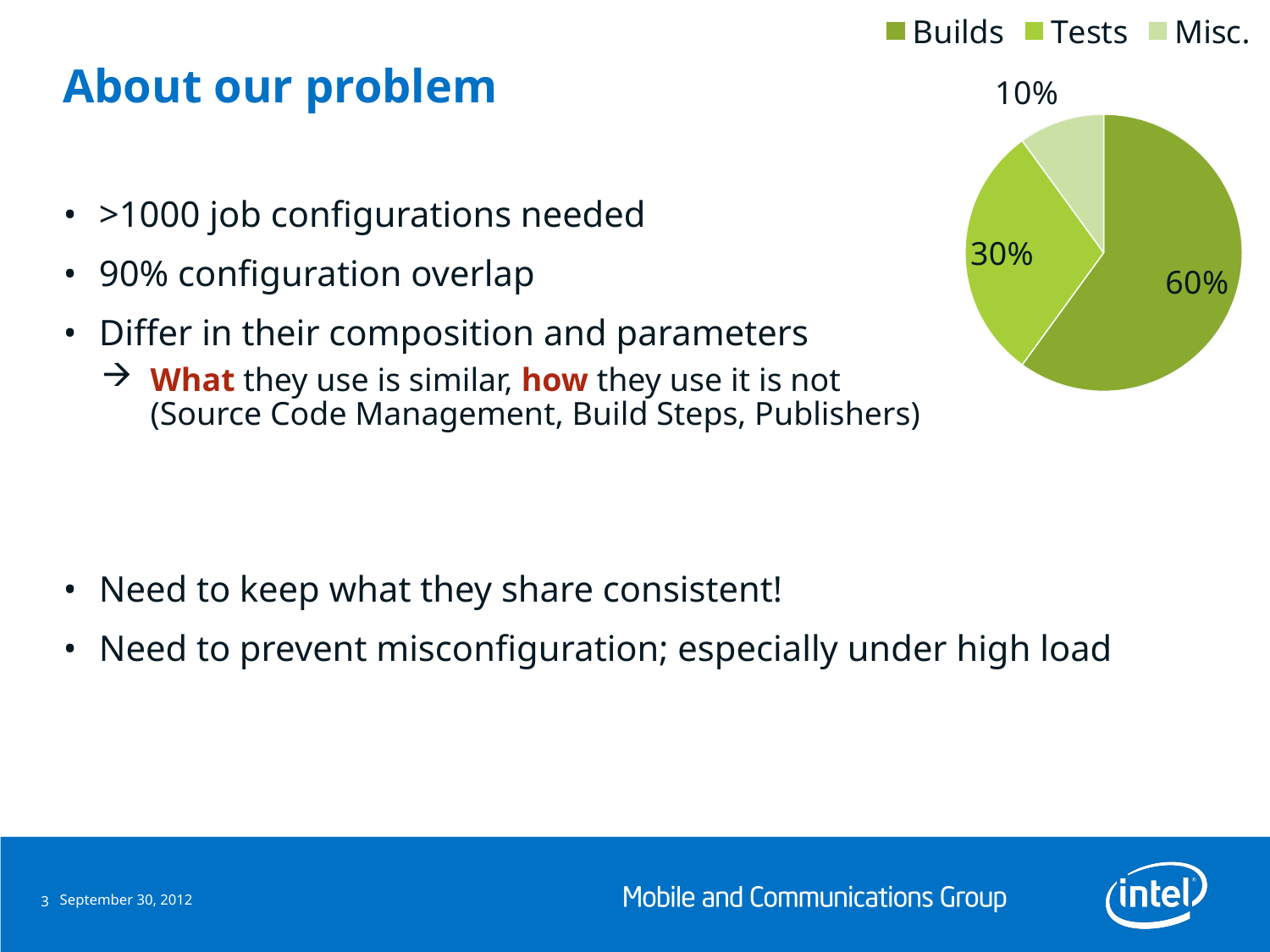
How many entries does the legend list? 3 What share of the pie does Tests take? 30% How many slices does the pie chart have? 3 What share of the pie does Misc. take? 10% What is the difference in percentage points between the Tests slice and the Misc. slice? 20% Which category has the largest slice of the pie? Builds What kind of chart is shown on the slide? pie chart What is the difference in percentage points between the Builds slice and the Tests slice? 30% Which legend entry is shown in the lightest green colour? Misc. What share of the pie does Builds take? 60% Which slice is larger, Tests or Misc.? Tests Which category has the smallest slice of the pie? Misc.